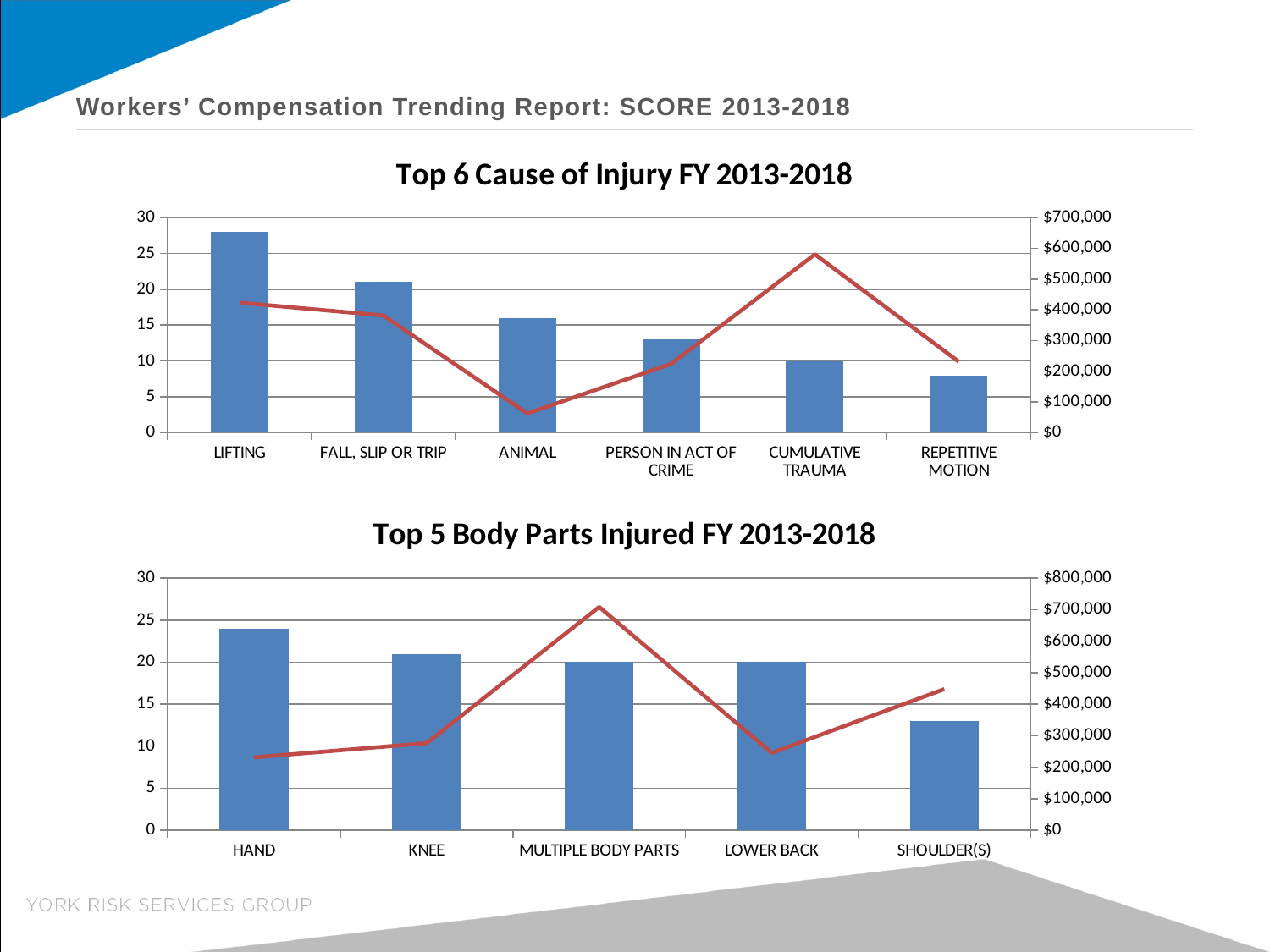
In the 'Top 6 Cause of Injury FY 2013-2018' chart, at which cause does the red line reach its highest point? CUMULATIVE TRAUMA In the 'Top 5 Body Parts Injured FY 2013-2018' chart, at which body part does the red line reach its highest point? MULTIPLE BODY PARTS In the 'Top 6 Cause of Injury FY 2013-2018' chart, which cause has the tallest bar? LIFTING In the 'Top 6 Cause of Injury FY 2013-2018' chart, which cause has the shortest bar? REPETITIVE MOTION In the 'Top 6 Cause of Injury FY 2013-2018' chart, at which cause does the red line reach its lowest point? ANIMAL In the 'Top 5 Body Parts Injured FY 2013-2018' chart, what is the bar value for LOWER BACK on the left axis? 20 How many causes of injury are shown in the 'Top 6 Cause of Injury FY 2013-2018' chart? 6 In the 'Top 6 Cause of Injury FY 2013-2018' chart, what is the bar value for CUMULATIVE TRAUMA on the left axis? 10 In the 'Top 5 Body Parts Injured FY 2013-2018' chart, do the bar values rise or fall from left to right? fall In the 'Top 5 Body Parts Injured FY 2013-2018' chart, is the bar value for SHOULDER(S) greater or less than 15? less In the 'Top 6 Cause of Injury FY 2013-2018' chart, is the bar value for LIFTING greater or less than 25? greater